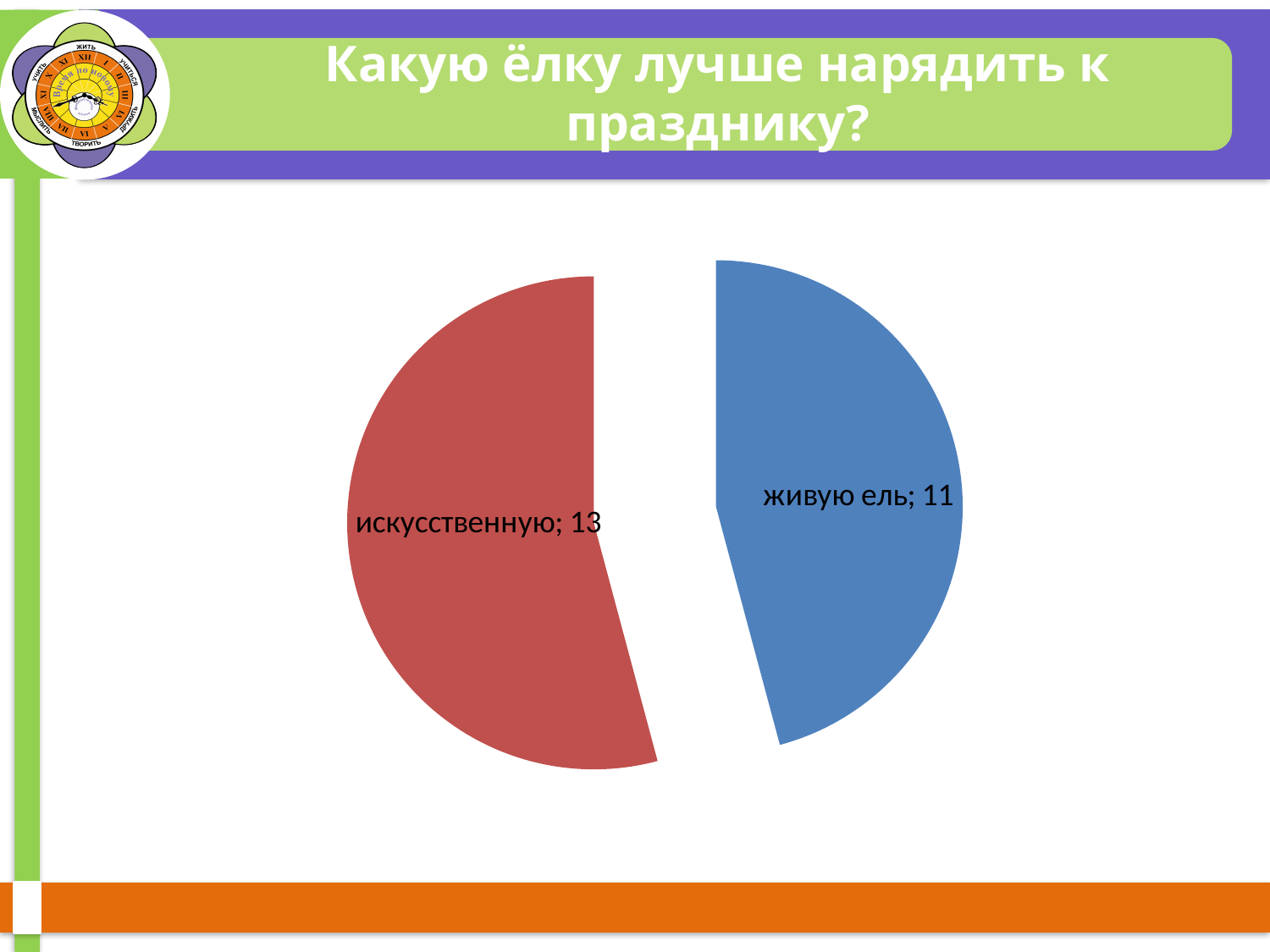
What is the title of the slide containing the pie chart? Какую ёлку лучше нарядить к празднику? What is the value for the slice labelled "живую ель"? 11 How many slices does the pie chart have? 2 What is the value for the slice labelled "искусственную"? 13 What colour is the slice labelled "живую ель"? blue Which is larger, the value for "искусственную" or the value for "живую ель"? искусственную Which slice of the pie chart has the lowest value? живую ель What is the difference between the values for "искусственную" and "живую ель"? 2 What kind of chart is shown on the slide? pie chart What is the total of all slices in the pie chart? 24 Which slice of the pie chart has the highest value? искусственную